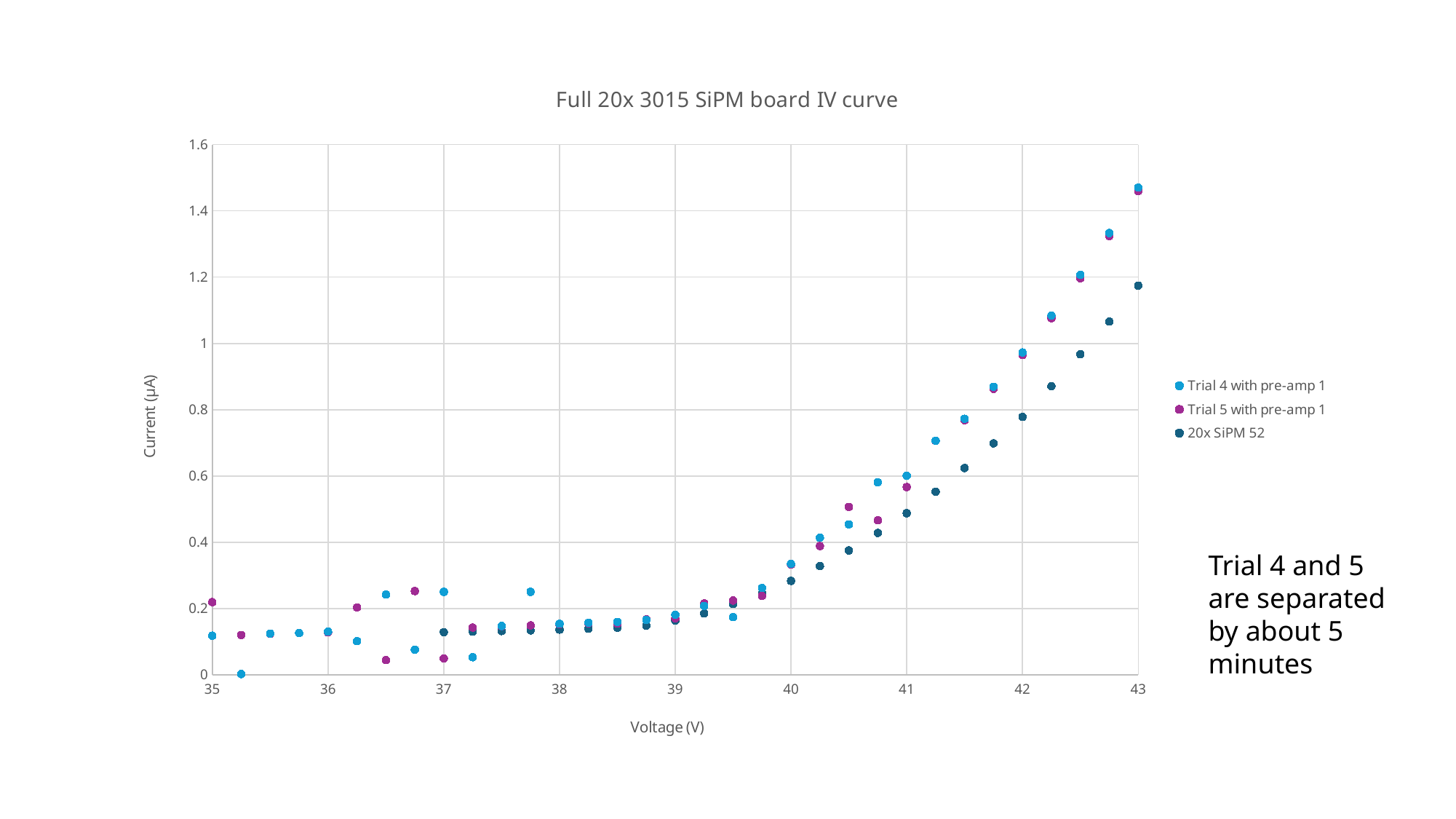
What is the title of the chart? Full 20x 3015 SiPM board IV curve At 42 V, is the value for Trial 5 with pre-amp 1 greater or less than 0.8? greater Between 40 V and 43 V, does the current for 20x SiPM 52 rise or fall as voltage increases? rise At 35 V, is the value for Trial 4 with pre-amp 1 greater or less than 0.2? less What is the label of the vertical axis? Current (µA) At 43 V, is the value for 20x SiPM 52 greater or less than 1? greater How many series does the legend list? 3 At 43 V, which is larger: Trial 4 with pre-amp 1 or 20x SiPM 52? Trial 4 with pre-amp 1 What kind of chart is shown on the slide? scatter chart At 42.5 V, which series has the lowest current? 20x SiPM 52